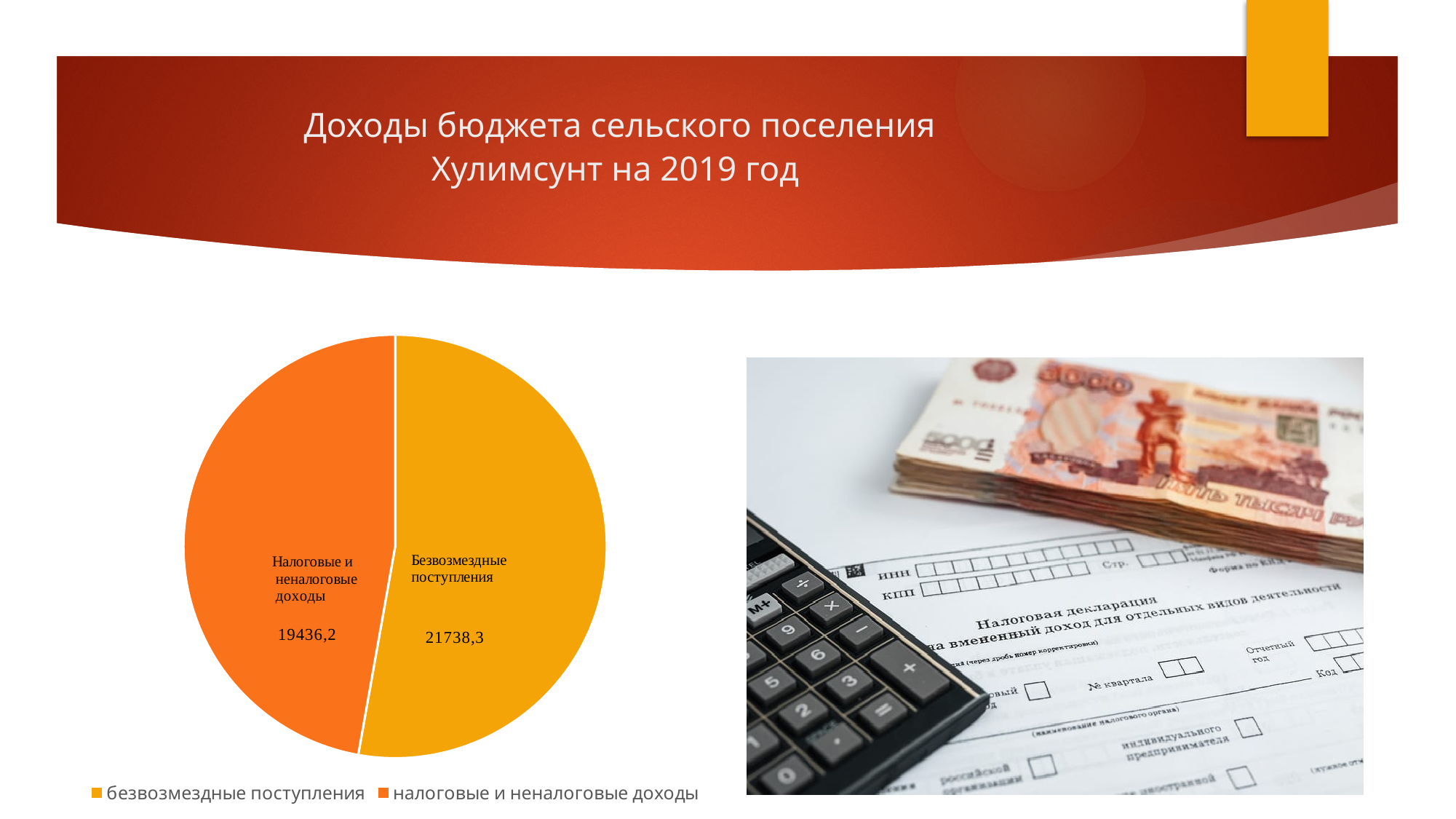
What is the title of the slide containing the pie chart? Доходы бюджета сельского поселения Хулимсунт на 2019 год What is the total of the two slices in the pie chart? 41174,5 What is the difference between Безвозмездные поступления and Налоговые и неналоговые доходы? 2302,1 Which slice of the pie chart has the smallest value? Налоговые и неналоговые доходы What is the value for Безвозмездные поступления in the pie chart? 21738,3 How many slices does the pie chart have? 2 Which slice of the pie chart has the largest value? Безвозмездные поступления How many entries does the legend of the pie chart list? 2 What type of chart is shown on the slide? pie chart Which is larger: Безвозмездные поступления or Налоговые и неналоговые доходы? Безвозмездные поступления What colour is the Безвозмездные поступления slice in the pie chart? yellow-orange What is the value for Налоговые и неналоговые доходы in the pie chart? 19436,2